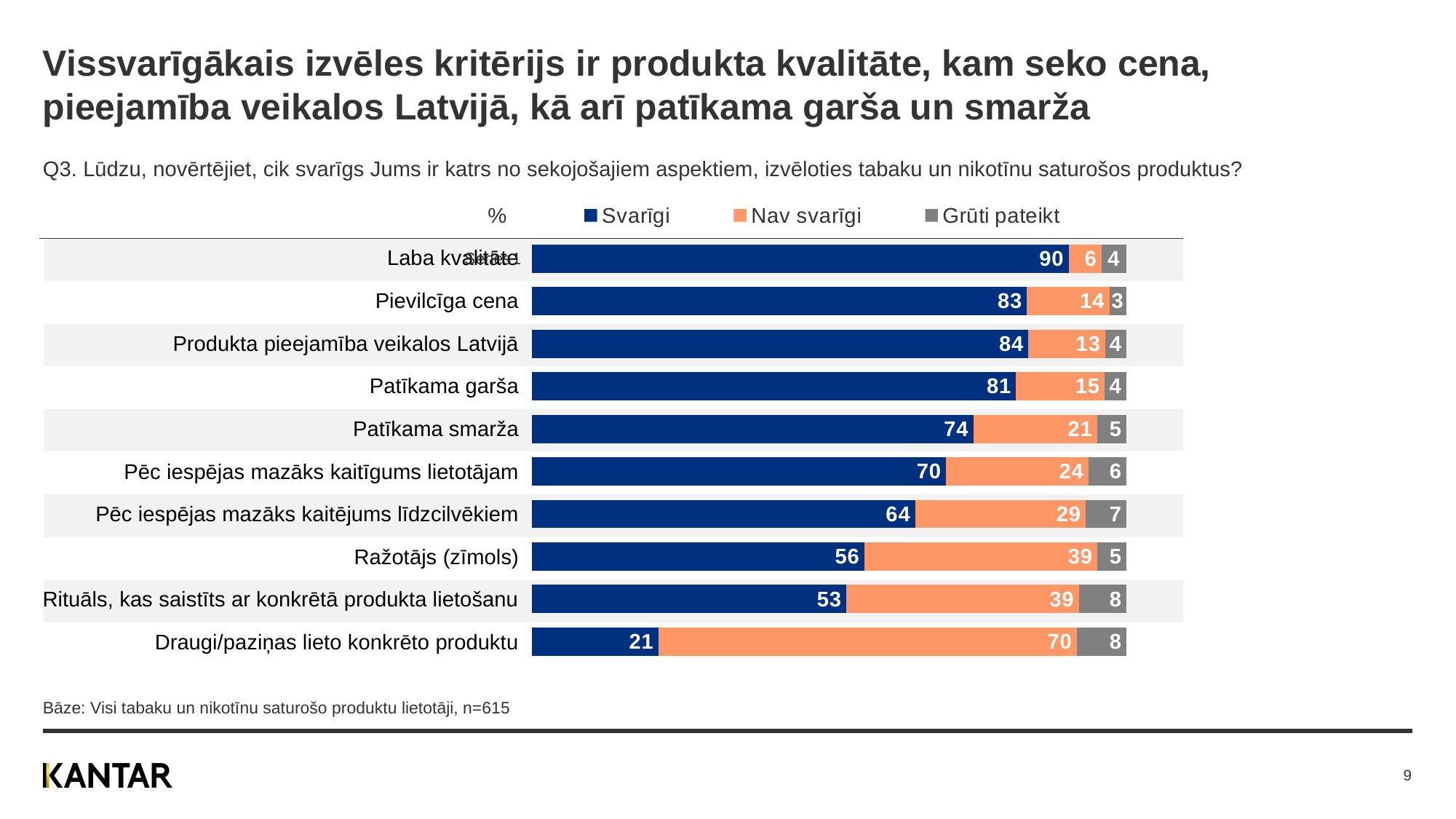
How many categories are shown in the chart? 10 What is the 'Svarīgi' value for 'Pievilcīga cena'? 83 Which series is shown in orange in the legend? Nav svarīgi What is the 'Grūti pateikt' value for 'Pēc iespējas mazāks kaitējums līdzcilvēkiem'? 7 Which has a larger 'Nav svarīgi' value: 'Ražotājs (zīmols)' or 'Pēc iespējas mazāks kaitīgums lietotājam'? Ražotājs (zīmols) Which category has the lowest 'Svarīgi' value? Draugi/paziņas lieto konkrēto produktu How many series does the legend list? 3 Which category has the highest 'Svarīgi' value? Laba kvalitāte What kind of chart is shown on the slide? Stacked bar chart What is the difference between the 'Svarīgi' values for 'Patīkama garša' and 'Patīkama smarža'? 7 What is the total of the stacked bar for 'Rituāls, kas saistīts ar konkrētā produkta lietošanu'? 100 What is the 'Nav svarīgi' value for 'Draugi/paziņas lieto konkrēto produktu'? 70